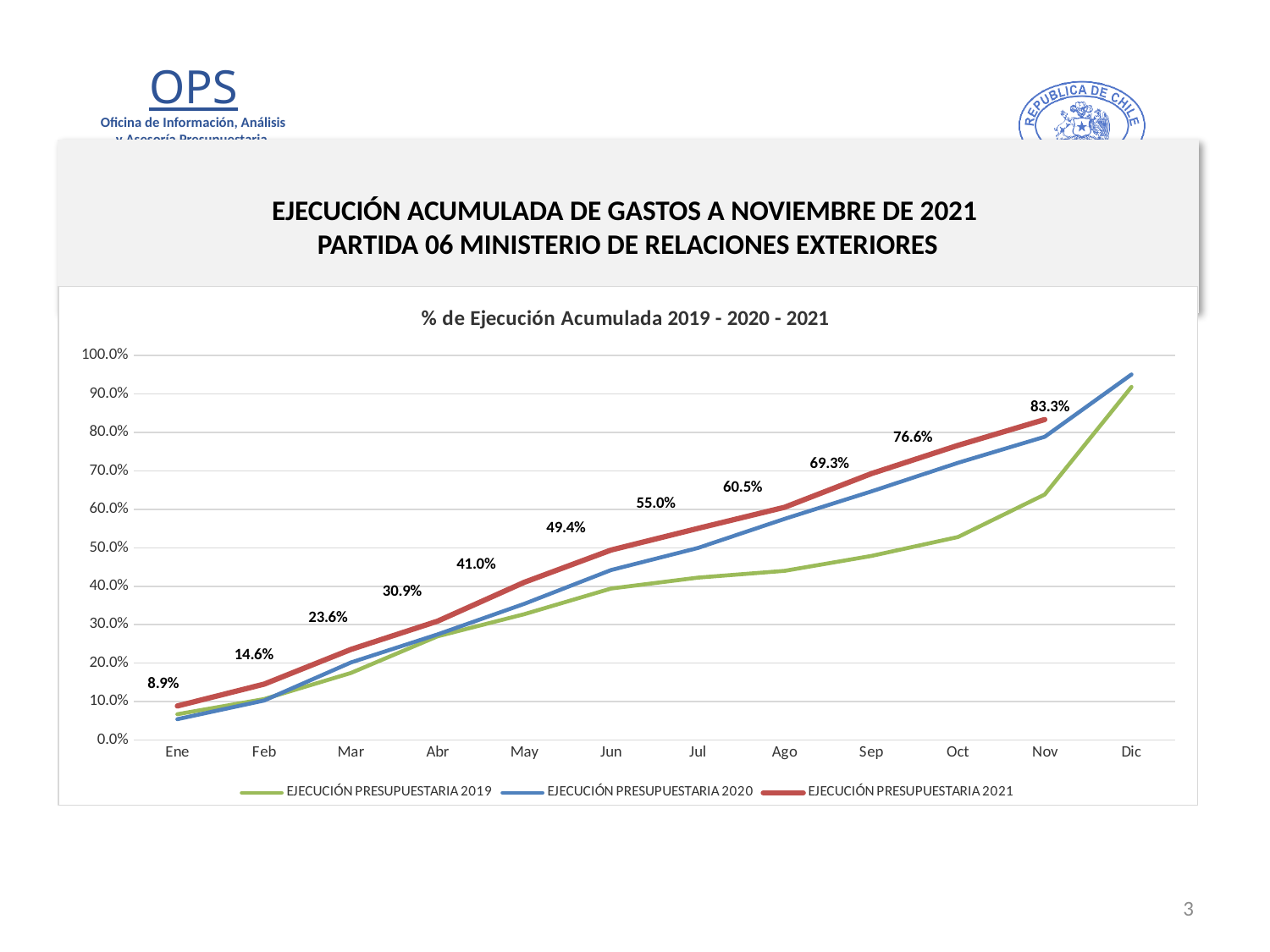
Do the values of EJECUCIÓN PRESUPUESTARIA 2021 rise or fall from Ene to Nov? Rise How many series does the legend list? 3 What is the value of EJECUCIÓN PRESUPUESTARIA 2021 in May? 41.0% In Oct, which series has the larger value: EJECUCIÓN PRESUPUESTARIA 2019 or EJECUCIÓN PRESUPUESTARIA 2021? EJECUCIÓN PRESUPUESTARIA 2021 What is the title of the chart? % de Ejecución Acumulada 2019 - 2020 - 2021 By how many percentage points did EJECUCIÓN PRESUPUESTARIA 2021 increase from Oct to Nov? 6.7 percentage points Is the value for EJECUCIÓN PRESUPUESTARIA 2020 in Dic greater or less than 90.0%? greater What kind of chart is shown on the slide? Line chart By how many percentage points did EJECUCIÓN PRESUPUESTARIA 2021 increase from May to Jun? 8.4 percentage points How many months are shown on the x axis? 12 What is the value of EJECUCIÓN PRESUPUESTARIA 2021 in Nov? 83.3% What is the value of EJECUCIÓN PRESUPUESTARIA 2021 in Ene? 8.9%